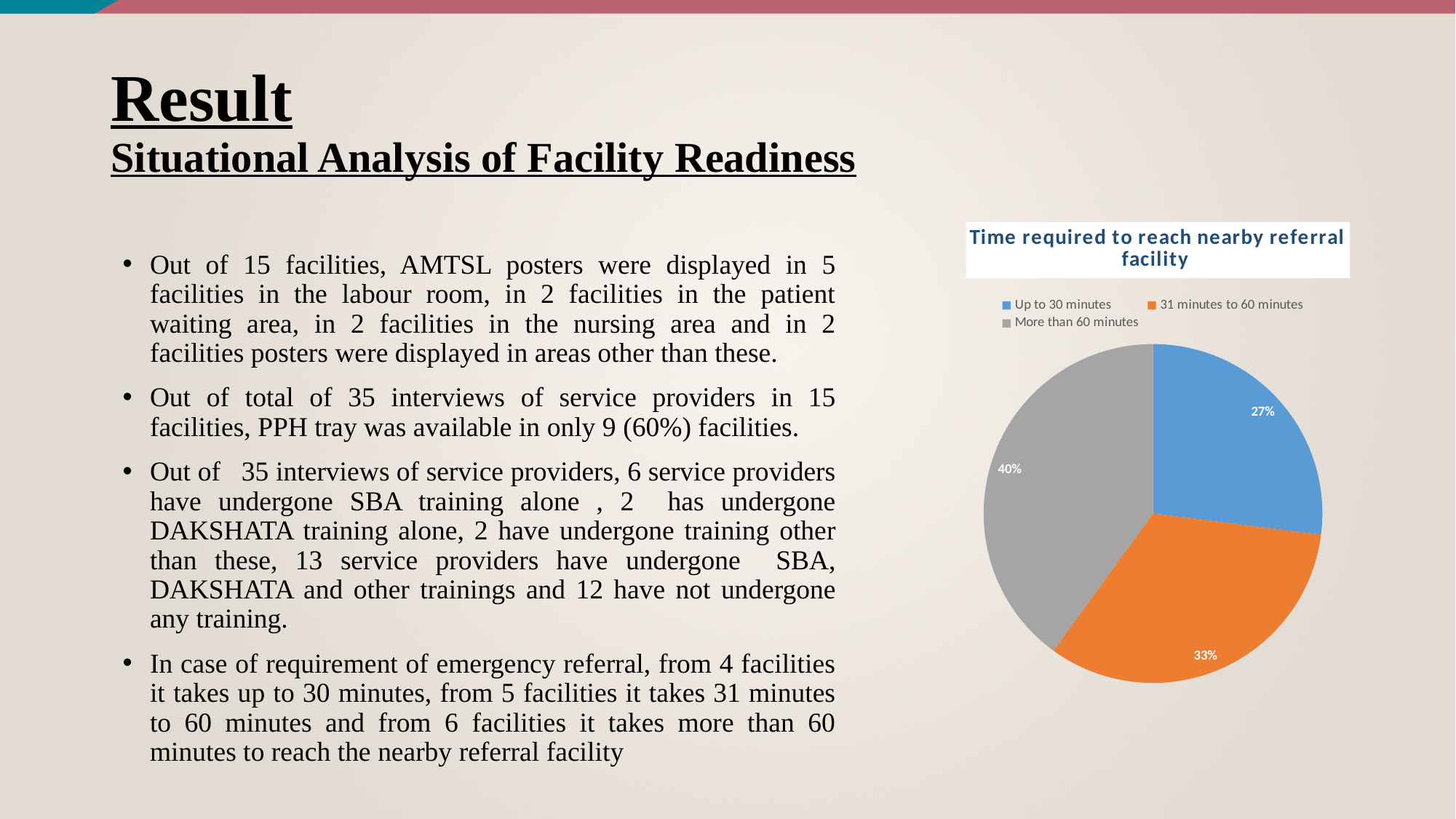
Which is larger: the share for '31 minutes to 60 minutes' or the share for 'Up to 30 minutes'? 31 minutes to 60 minutes What colour is the slice for 'More than 60 minutes'? grey Which category has the smallest share of the pie? Up to 30 minutes What type of chart is shown on the slide? pie chart What is the difference in percentage points between 'More than 60 minutes' and 'Up to 30 minutes'? 13 What share of the pie is labelled for 'Up to 30 minutes'? 27% What share of the pie is labelled for 'More than 60 minutes'? 40% What share of the pie is labelled for '31 minutes to 60 minutes'? 33% How many entries does the legend list? 3 How many slices does the pie chart have? 3 What is the title of the chart? Time required to reach nearby referral facility Which category has the largest share of the pie? More than 60 minutes